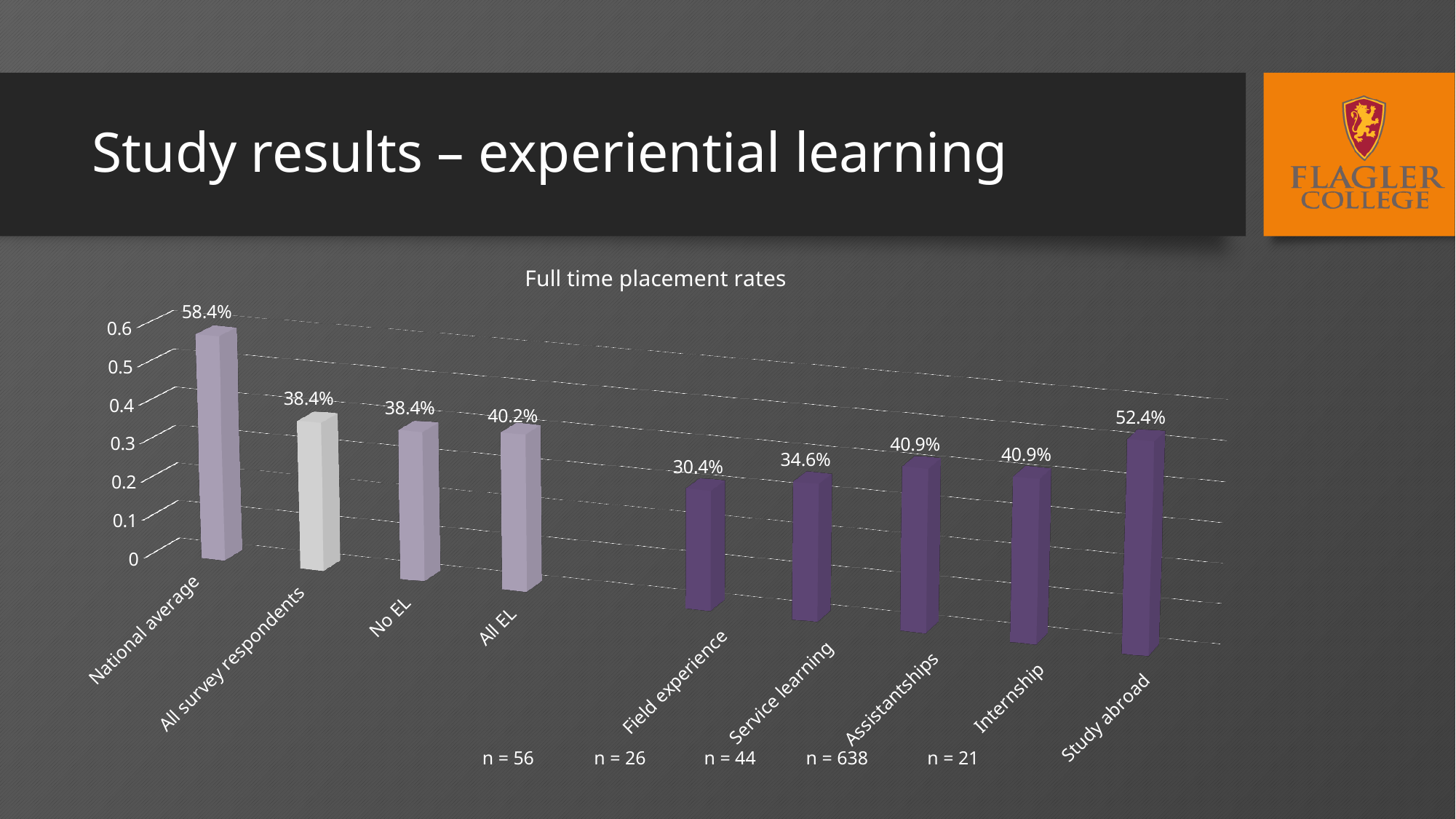
Which category has the highest full time placement rate? National average What is the difference between the All EL placement rate and the No EL placement rate? 1.8% What is the title of the chart? Full time placement rates What is the full time placement rate for Field experience? 30.4% What is the full time placement rate for Study abroad? 52.4% Which category has the lowest full time placement rate? Field experience What is the full time placement rate for All EL? 40.2% Which has a higher full time placement rate, Service learning or Assistantships? Assistantships How many labelled categories are shown on the chart? 9 What is the difference between the National average placement rate and the Study abroad placement rate? 6.0% What is the full time placement rate for the National average? 58.4% What type of chart is shown on the slide? Bar chart